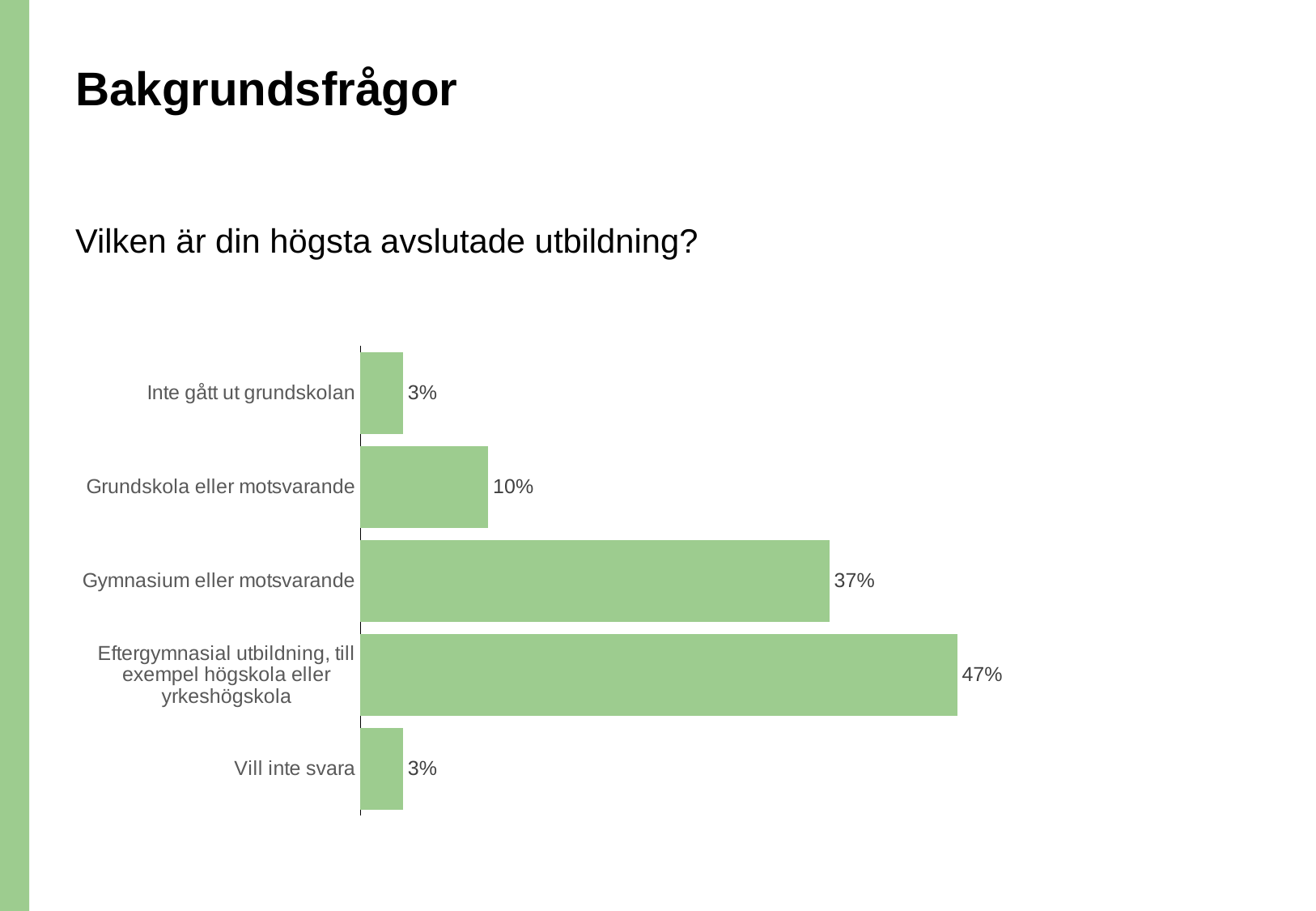
What colour are the bars in the chart? Green What is the value for "Vill inte svara"? 3% Which is larger: the value for "Gymnasium eller motsvarande" or for "Grundskola eller motsvarande"? Gymnasium eller motsvarande What percentage of respondents answered "Gymnasium eller motsvarande"? 37% What is the value shown for "Grundskola eller motsvarande"? 10% What percentage is shown for "Eftergymnasial utbildning, till exempel högskola eller yrkeshögskola"? 47% How many categories are shown in the chart? 5 What question does the chart answer, as written above it? Vilken är din högsta avslutade utbildning? What kind of chart is shown on the slide? Bar chart What is the difference between "Grundskola eller motsvarande" and "Inte gått ut grundskolan"? 7 percentage points Which category has the highest value? Eftergymnasial utbildning, till exempel högskola eller yrkeshögskola What is the difference between the values for "Eftergymnasial utbildning" and "Gymnasium eller motsvarande"? 10 percentage points